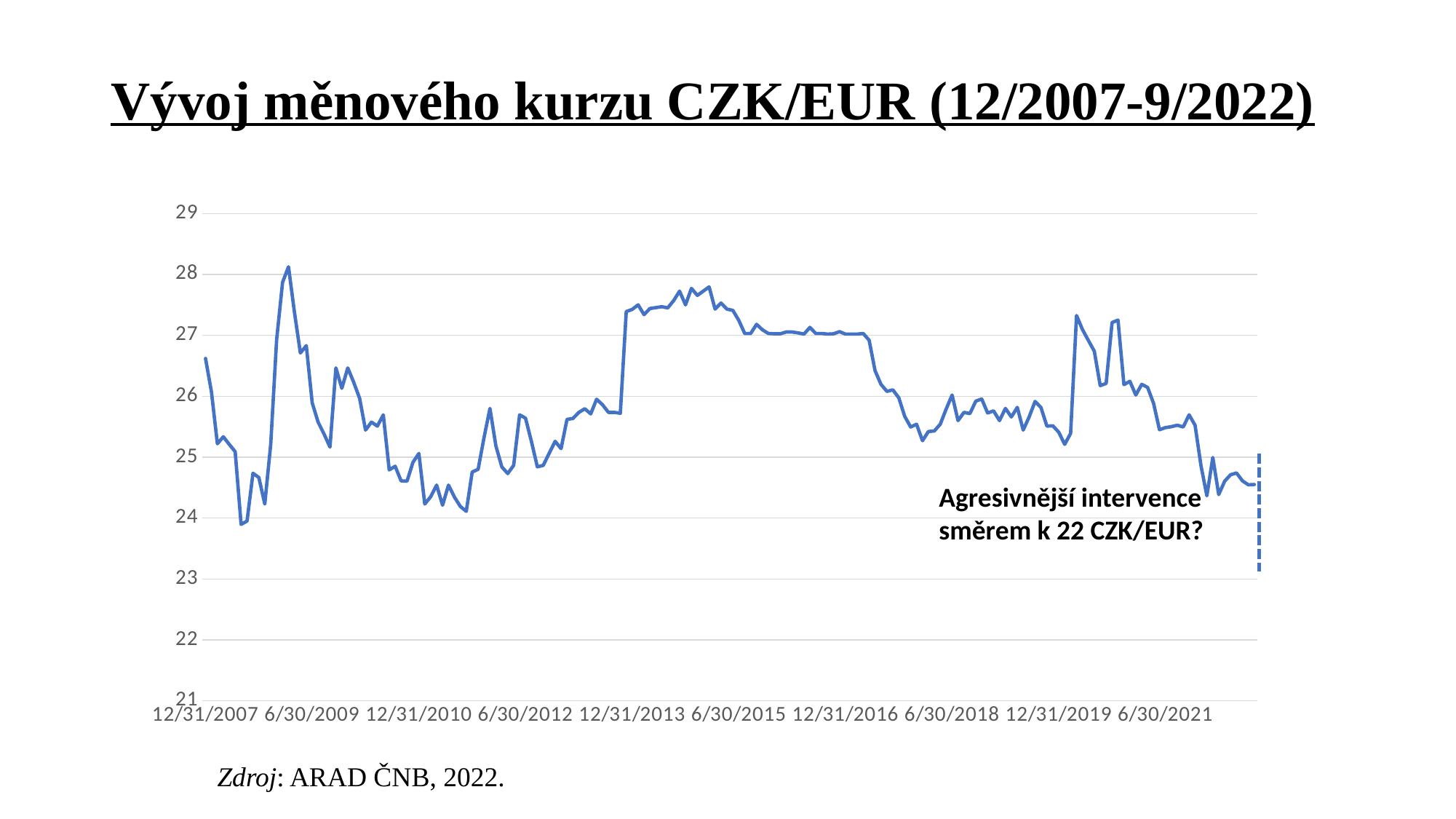
How many lines (data series) are plotted on the chart? 1 What kind of chart is shown on the slide? line chart Is the highest value reached by the line greater or less than 27? greater Is the value at 6/30/2012 greater or less than 26? less Comparing the start of the series (12/31/2007) with its end (2022), does the exchange rate rise or fall overall? fall Is the value at 12/31/2007 greater or less than 26? greater Which is larger, the value at 12/31/2013 or the value at 6/30/2018? 12/31/2013 What is the title of the chart on the slide? Vývoj měnového kurzu CZK/EUR (12/2007-9/2022) How many date labels are shown along the x axis? 10